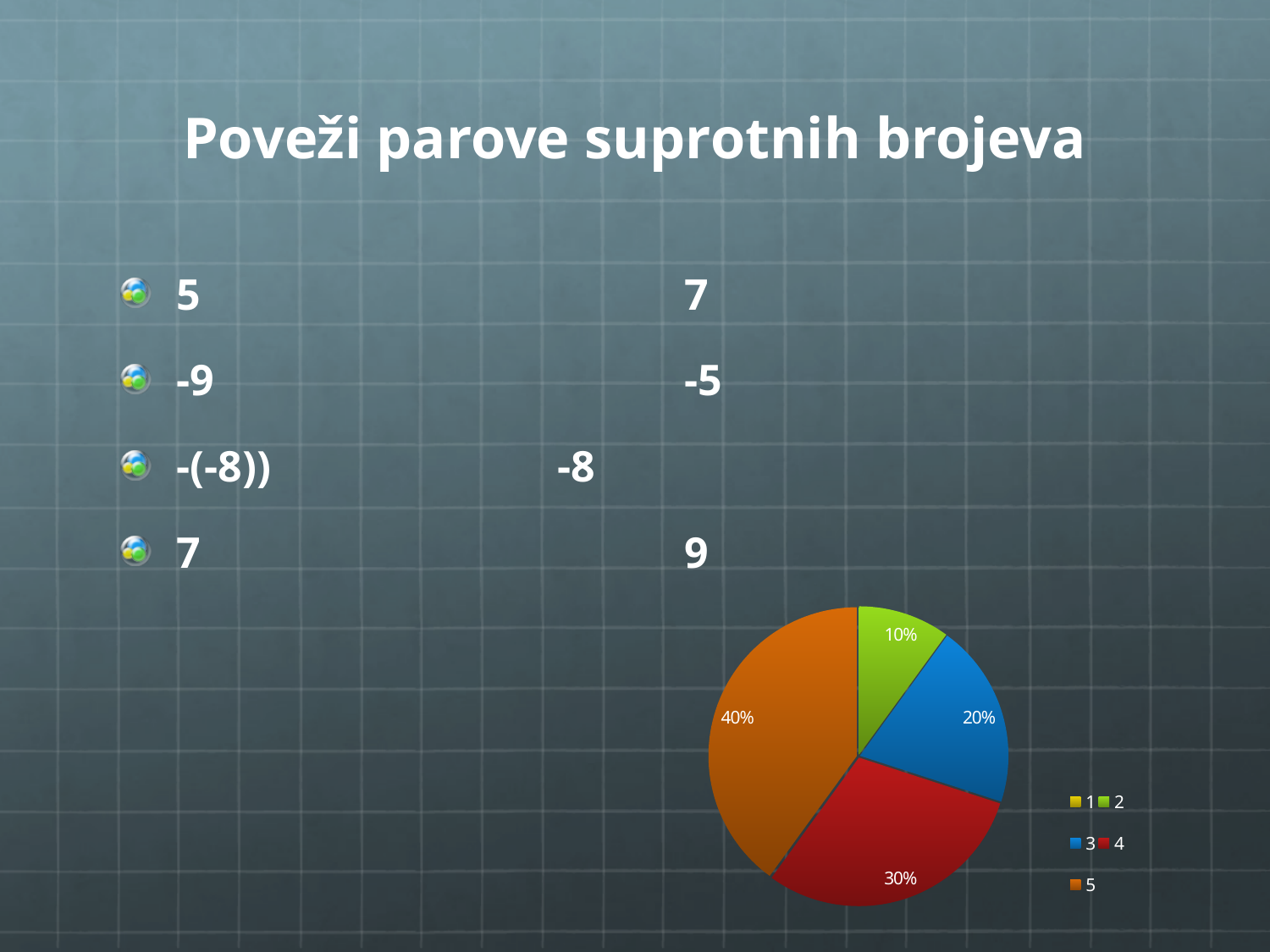
What colour is the largest slice of the pie chart? orange What do the four percentages printed on the pie chart add up to? 100% What percentage does the orange slice (legend entry 5) of the pie chart show? 40% What percentage does the red slice (legend entry 4) of the pie chart show? 30% What is the difference in percentage points between the largest slice (40%) and the smallest labelled slice (10%)? 30 What percentage does the green slice (legend entry 2) of the pie chart show? 10% What percentage does the blue slice (legend entry 3) of the pie chart show? 20% Which legend entry has the largest slice in the pie chart? 5 How many entries does the legend of the pie chart list? 5 What kind of chart is shown on the slide? pie chart Which slice is larger in the pie chart, the one for legend entry 4 or the one for legend entry 5? 5 What is the smallest percentage printed on the pie chart? 10%